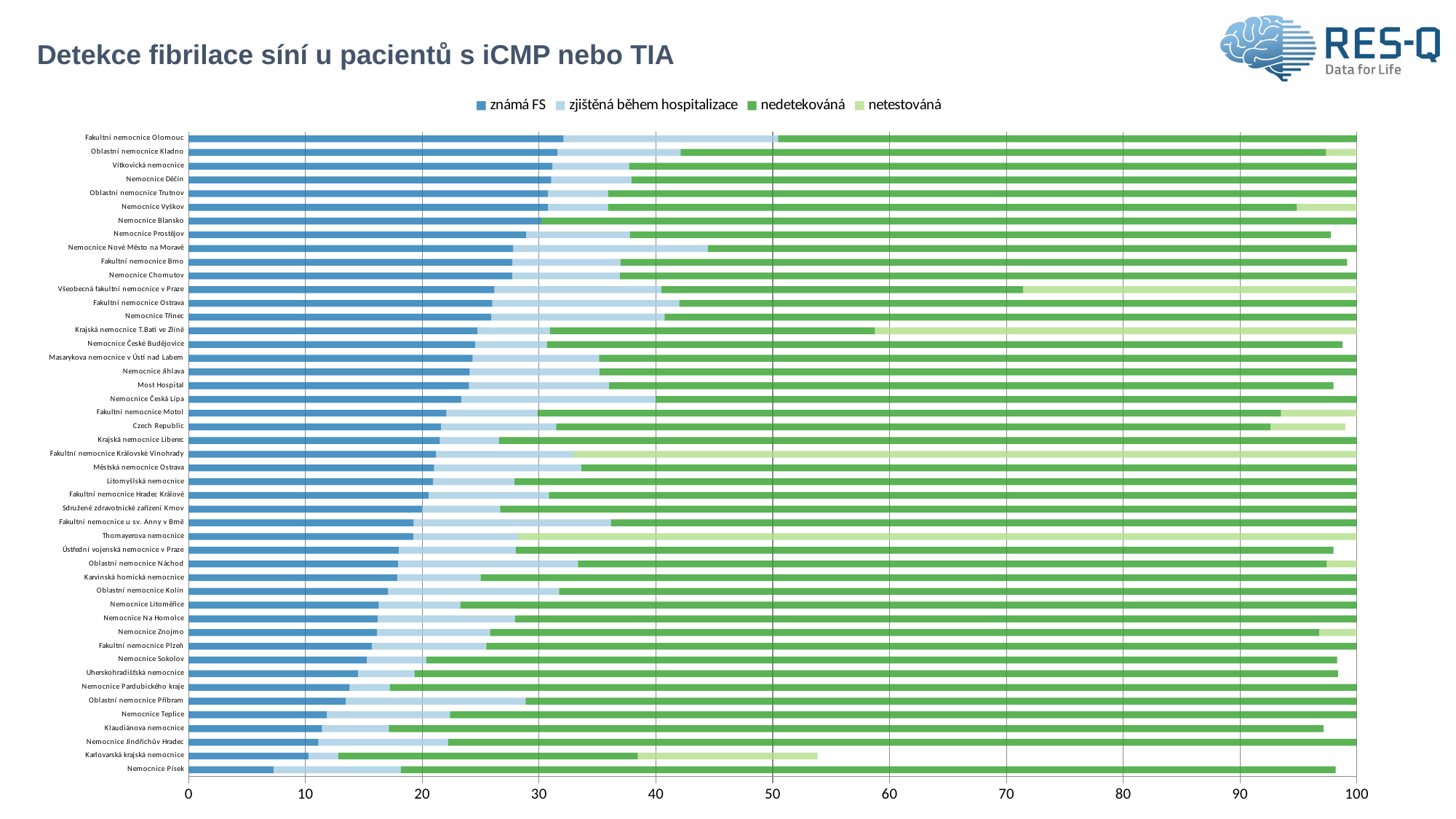
What kind of chart is shown on the slide? bar chart Which hospital has the lowest známá FS value? Nemocnice Písek What is the title of the slide's chart? Detekce fibrilace síní u pacientů s iCMP nebo TIA Is the total bar length for Karlovarská krajská nemocnice greater or less than 60? less Do the známá FS values rise or fall going from the top bar to the bottom bar? fall Which is larger, the netestováná segment for Fakultní nemocnice Královské Vinohrady or for Fakultní nemocnice Olomouc? Fakultní nemocnice Královské Vinohrady Which is larger, the známá FS value for Fakultní nemocnice Olomouc or for Nemocnice Písek? Fakultní nemocnice Olomouc Is the známá FS value for Nemocnice Teplice greater or less than 20? less How many series does the legend list? 4 Is the známá FS value for Nemocnice Písek greater or less than 10? less Which series are listed in the legend? známá FS, zjištěná během hospitalizace, nedetekováná, netestováná